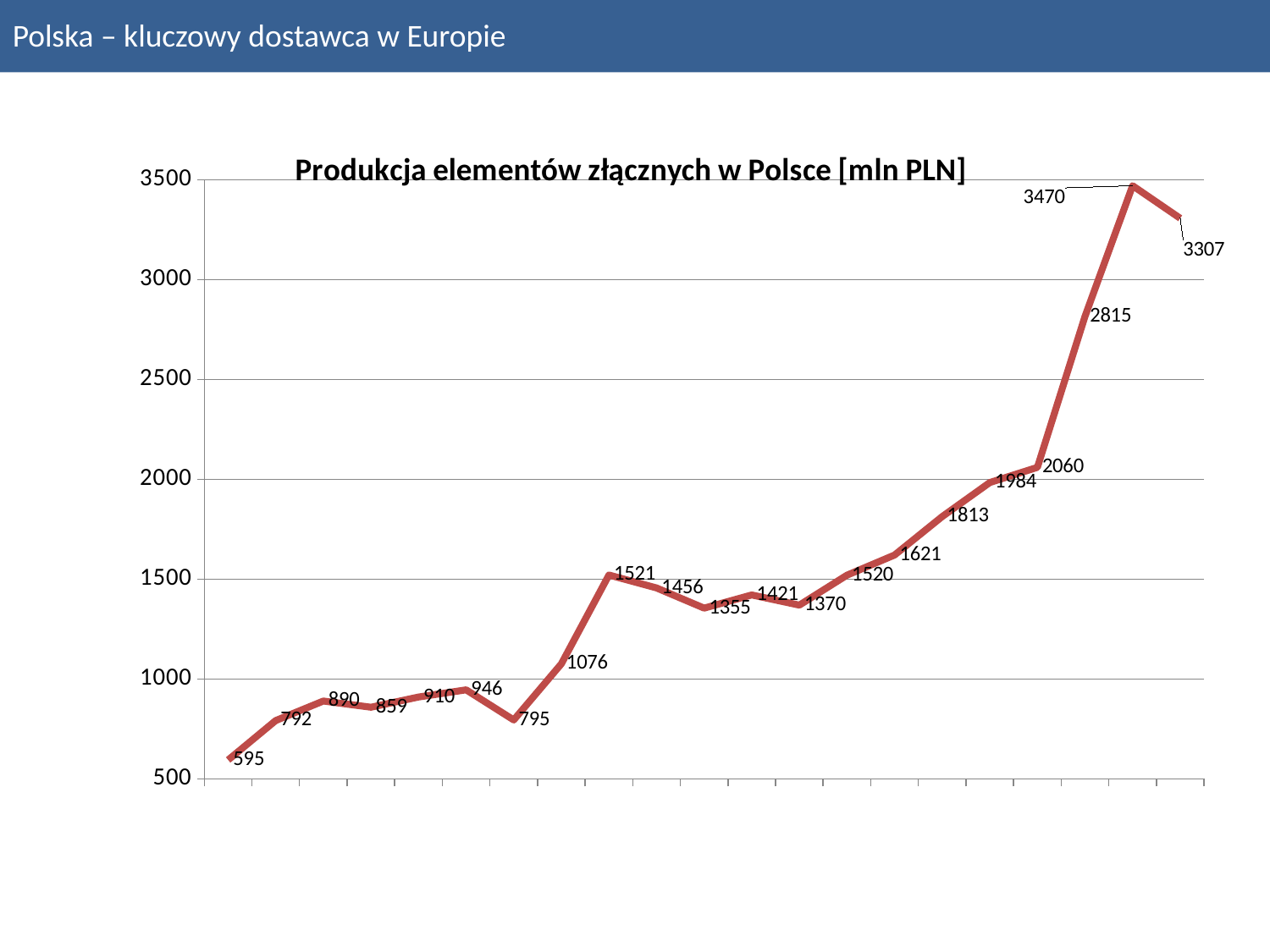
Is the value of the last data point greater or less than 3000? greater Overall, do the values rise or fall from left to right along the x axis? rise What is the highest value labelled on the chart? 3470 What is the value of the last data point on the line? 3307 What is the title of the chart? Produkcja elementów złącznych w Polsce [mln PLN] What is the difference between the peak value (3470) and the final value (3307)? 163 Which is larger: the value labelled 1521 or the value labelled 1456? 1521 What is the value of the first data point on the line? 595 What is the difference between the values labelled 2815 and 2060? 755 How many data points are plotted on the line? 21 What kind of chart is shown on the slide? line chart What is the lowest value labelled on the chart? 595